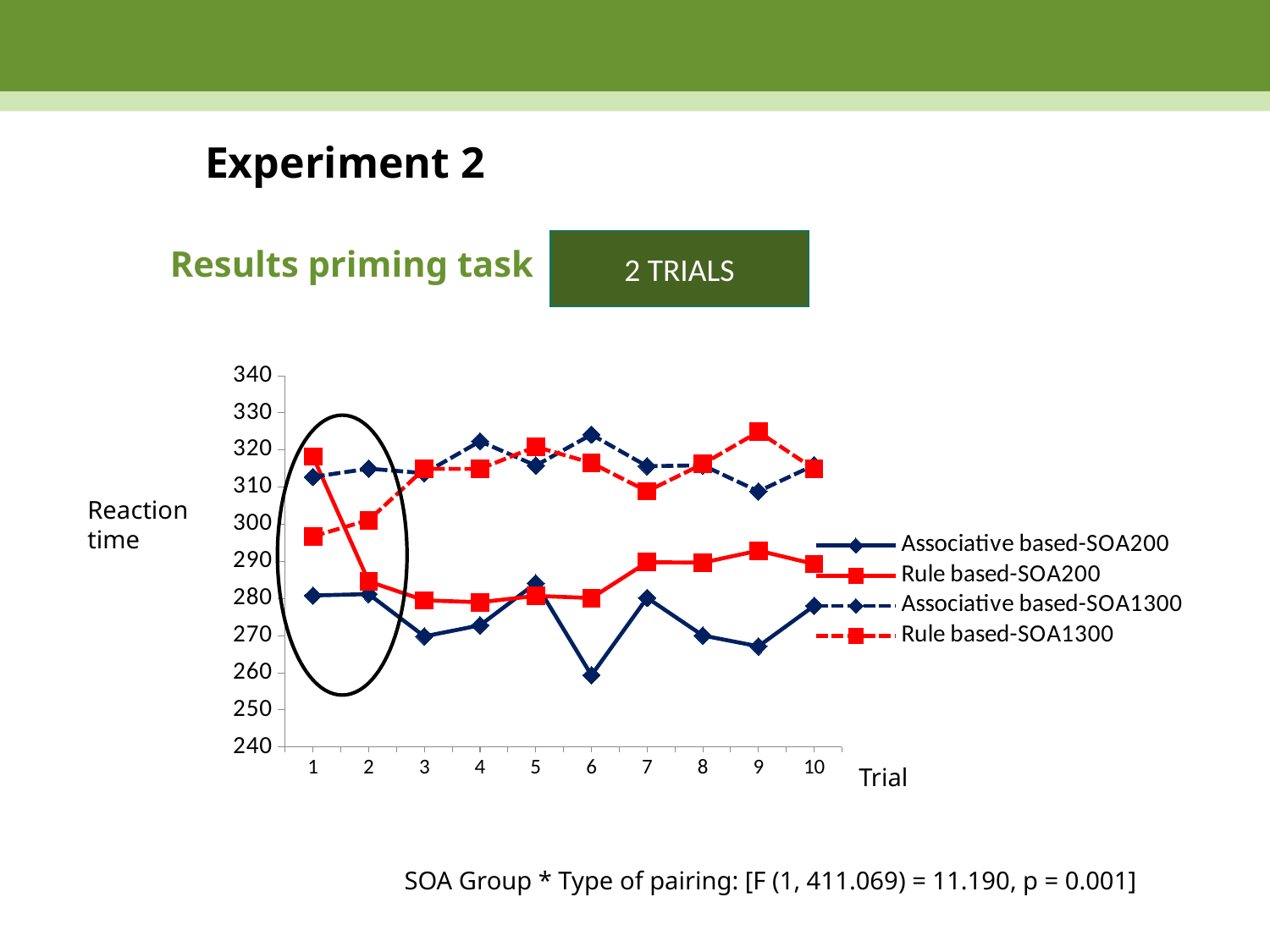
Is the value for Rule based-SOA1300 at trial 1 greater or less than 310? less Does the Rule based-SOA200 series rise or fall from trial 1 to trial 2? fall Is the value for Associative based-SOA1300 at trial 6 greater or less than 320? greater How many series does the legend list? 4 How many trials are plotted along the x axis? 10 At which trial does the Associative based-SOA200 series reach its lowest value? 6 Is the value for Associative based-SOA200 at trial 6 greater or less than 270? less Which series has the lowest value at trial 6? Associative based-SOA200 What is the label on the y axis of the chart? Reaction time At trial 1, which is larger: Rule based-SOA200 or Associative based-SOA200? Rule based-SOA200 What kind of chart is shown on the slide? line chart